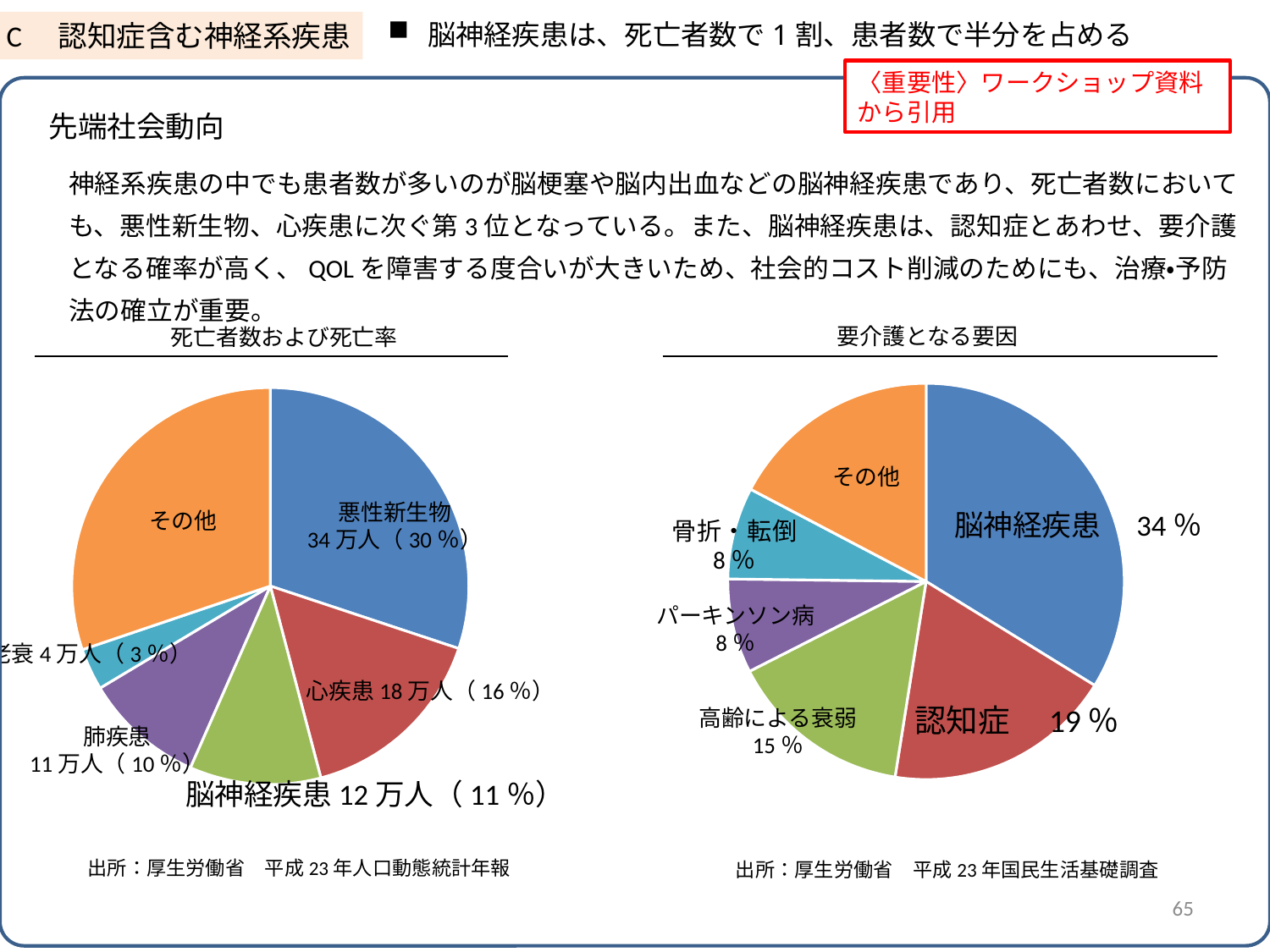
In the 死亡者数および死亡率 chart, what percentage share does 心疾患 have? 16% In the 死亡者数および死亡率 chart, which has more deaths, 肺疾患 or 脳神経疾患? 脳神経疾患 In the 要介護となる要因 chart, what share does 認知症 have? 19% In the 死亡者数および死亡率 chart, how many deaths are attributed to 脳神経疾患? 12万人 In the 死亡者数および死亡率 chart, how many deaths are attributed to 悪性新生物? 34万人 What kind of chart is the 死亡者数および死亡率 chart on the left? pie chart In the 要介護となる要因 chart, what is the difference in share between 脳神経疾患 and 認知症? 15% What is the source cited below the 要介護となる要因 chart? 厚生労働省 平成23年国民生活基礎調査 In the 要介護となる要因 chart, what share does 高齢による衰弱 have? 15% In the 要介護となる要因 chart, which factor has the largest share? 脳神経疾患 How many slices does the 死亡者数および死亡率 pie chart have? 6 In the 死亡者数および死亡率 chart, what is the difference in deaths between 悪性新生物 and 心疾患? 16万人